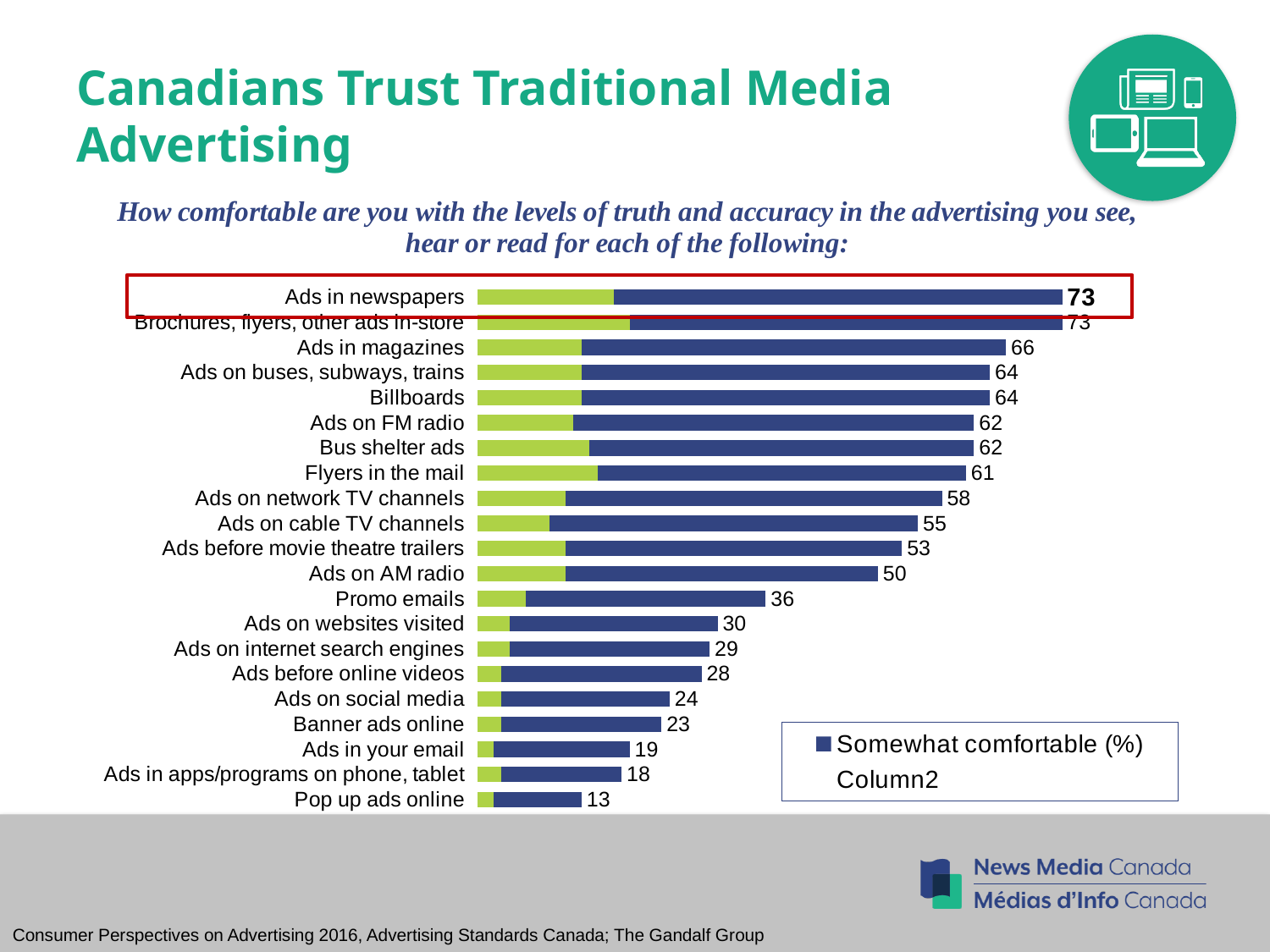
How many series does the legend list? 2 What is the difference between the values for Ads in newspapers and Pop up ads online? 60 What value is shown for Ads on social media? 24 Which has a larger value, Flyers in the mail or Ads before movie theatre trailers? Flyers in the mail Which category has the lowest value? Pop up ads online What value is shown for Ads in magazines? 66 Which has a larger value, Banner ads online or Ads on websites visited? Ads on websites visited What value is shown for Promo emails? 36 What kind of chart is shown on the slide? Bar chart What value is shown for Ads on AM radio? 50 What is the difference between the values for Ads on network TV channels and Ads on cable TV channels? 3 How many categories are shown in the chart? 21